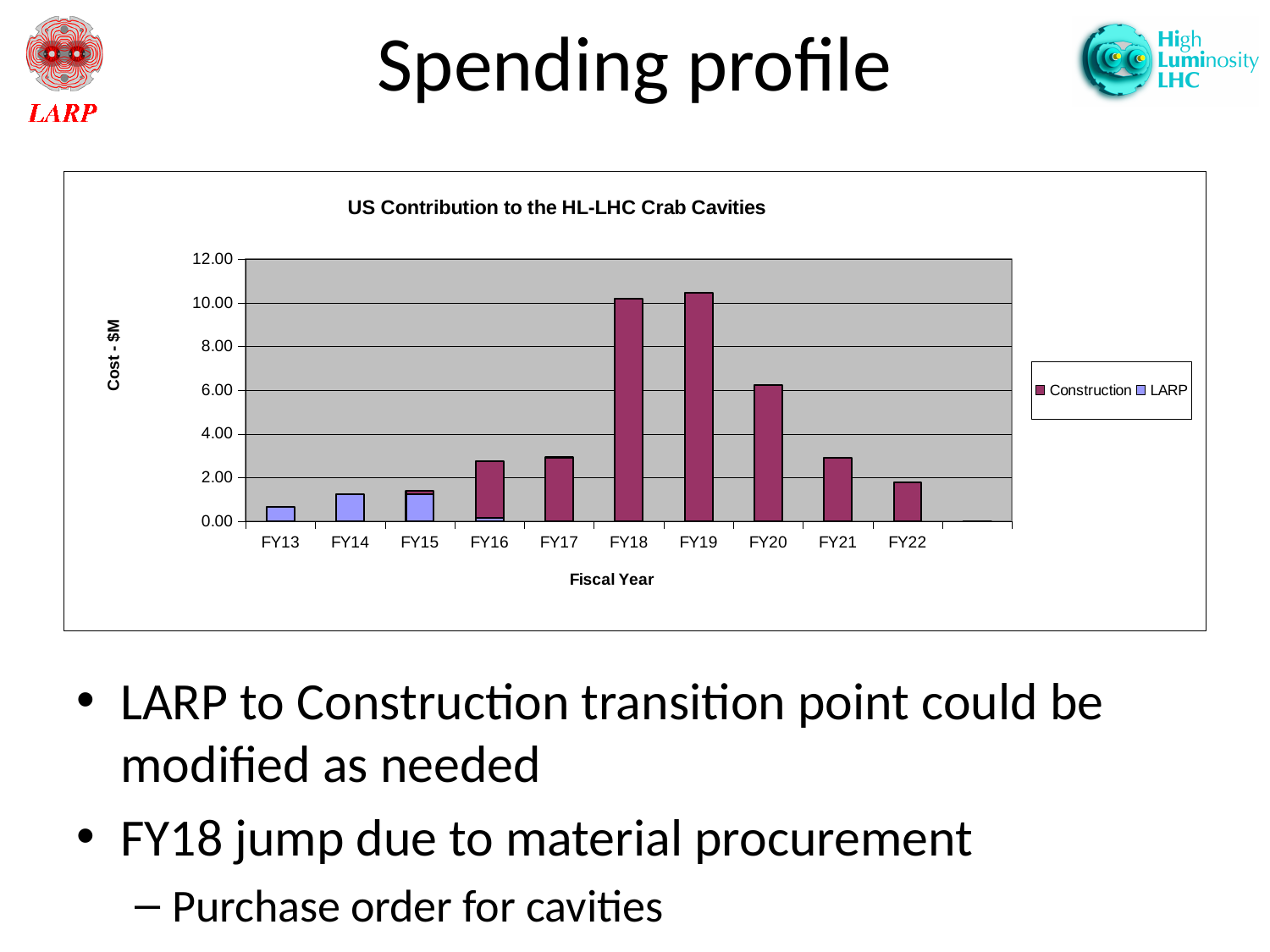
How many series does the chart legend list? 2 Do the bar values rise or fall from FY19 to FY22? fall Which bar is taller, FY21 or FY22? FY21 How many fiscal years are labelled on the x axis of the chart? 10 Which bar is taller, FY18 or FY20? FY18 Is the value for FY18 greater or less than 10.00? greater What kind of chart is shown on the slide? bar chart What is the title of the chart? US Contribution to the HL-LHC Crab Cavities What is the label of the y axis? Cost - $M Which labelled fiscal year has the lowest total bar? FY13 Is the value for FY13 greater or less than 2.00? less Is the value for FY20 greater or less than 8.00? less